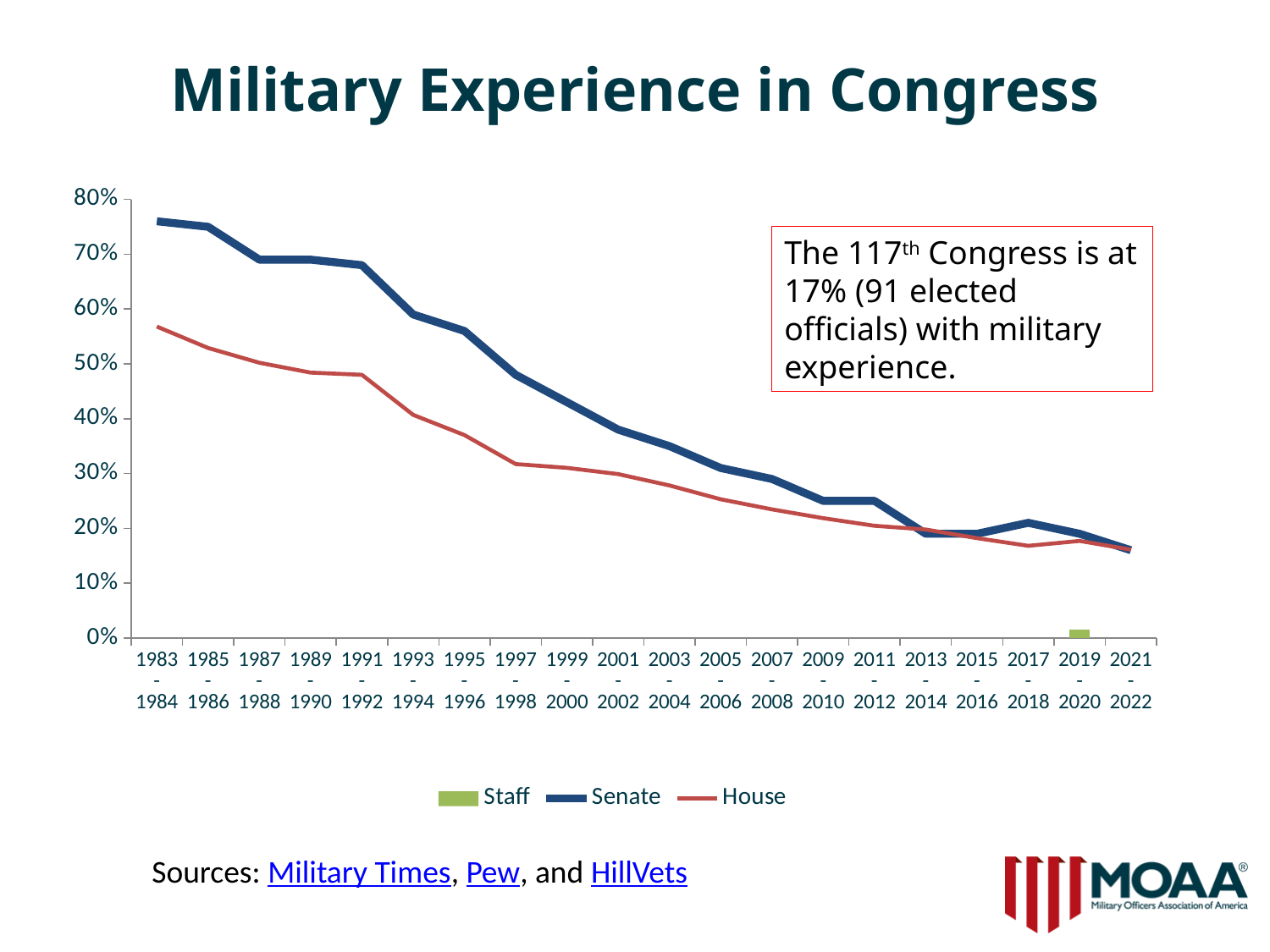
Is the Senate value for 1983-1984 greater or less than 70%? greater How many series does the legend list? 3 What kind of chart is shown on the slide? Combination bar and line chart In which period is the Senate value lowest? 2021-2022 Which series is shown in green in the legend? Staff How many Congress periods are shown along the x axis? 20 Do the Senate values rise or fall from 1983-1984 to 2021-2022? Fall Is the Senate value for 2021-2022 greater or less than 20%? less Which series has the larger value in 1983-1984, Senate or House? Senate What is the title of the chart? Military Experience in Congress In which period is the Senate value highest? 1983-1984 Is the House value for 1983-1984 greater or less than 50%? greater